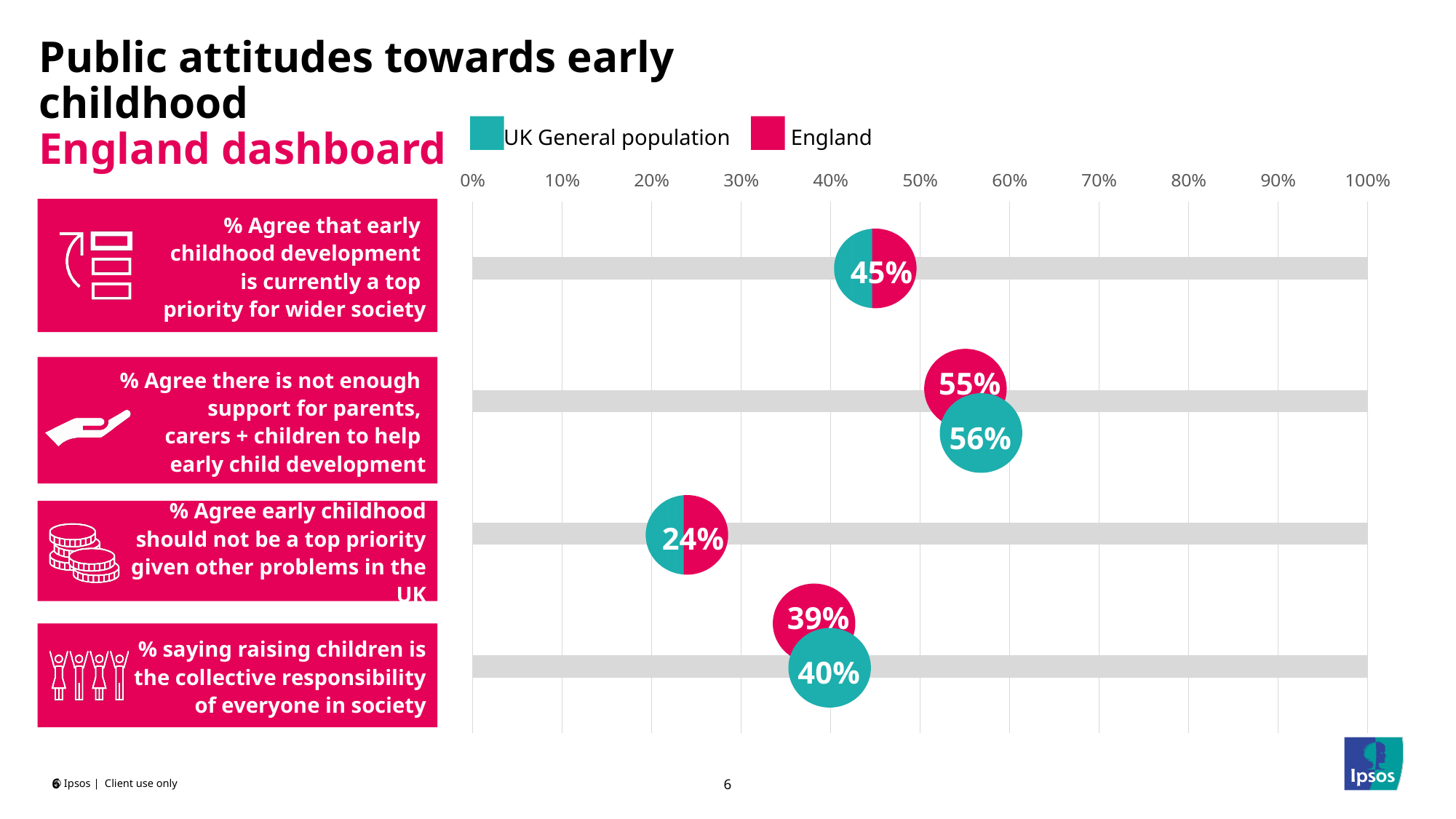
What is the England value for '% Agree there is not enough support for parents, carers + children to help early child development'? 55% What is the difference between the UK General population and England values for '% saying raising children is the collective responsibility of everyone in society'? 1 percentage point Which statement has the highest value on the chart? % Agree there is not enough support for parents, carers + children to help early child development How many statements (categories) are plotted on the chart? 4 What is the UK General population value for '% saying raising children is the collective responsibility of everyone in society'? 40% Which statement has the lowest value on the chart? % Agree early childhood should not be a top priority given other problems in the UK What value is shown for '% Agree early childhood should not be a top priority given other problems in the UK'? 24% What is the England value for '% saying raising children is the collective responsibility of everyone in society'? 39% How many series does the legend list? 2 What is the UK General population value for '% Agree there is not enough support for parents, carers + children to help early child development'? 56% What value is shown for '% Agree that early childhood development is currently a top priority for wider society'? 45% Which colour represents England in the legend? Pink